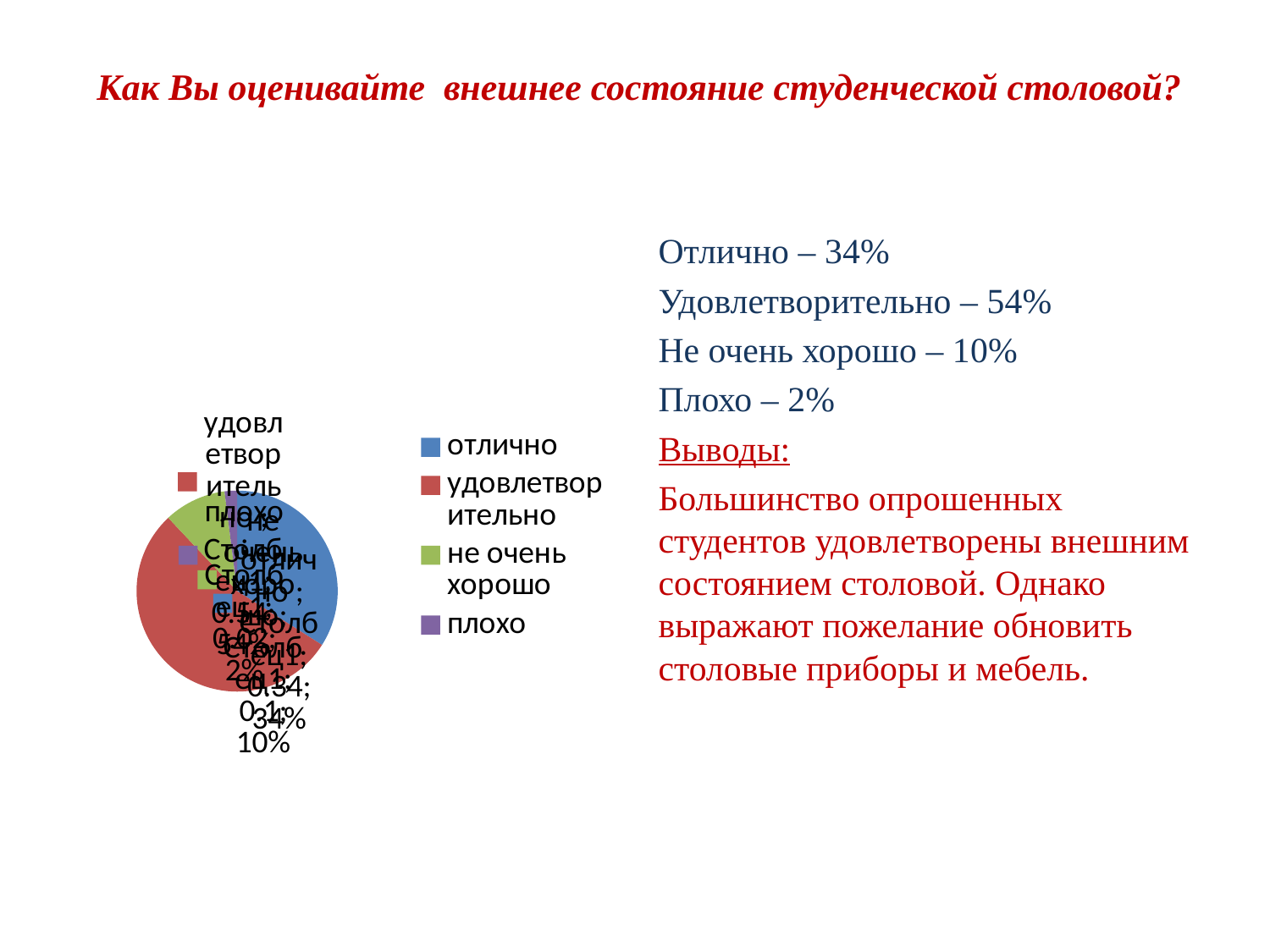
What percentage of respondents answered "отлично"? 34% What colour is the "удовлетворительно" slice in the pie chart? red Which category has the largest slice of the pie chart? удовлетворительно How many categories does the pie chart's legend list? 4 What percentage of respondents answered "удовлетворительно"? 54% Which slice is larger: "отлично" or "не очень хорошо"? отлично By how many percentage points does "удовлетворительно" exceed "отлично"? 20% What colour is the "отлично" slice in the pie chart? blue What percentage of respondents answered "плохо"? 2% What percentage of respondents answered "не очень хорошо"? 10% What kind of chart is shown on the slide? pie chart Which category has the smallest slice of the pie chart? плохо